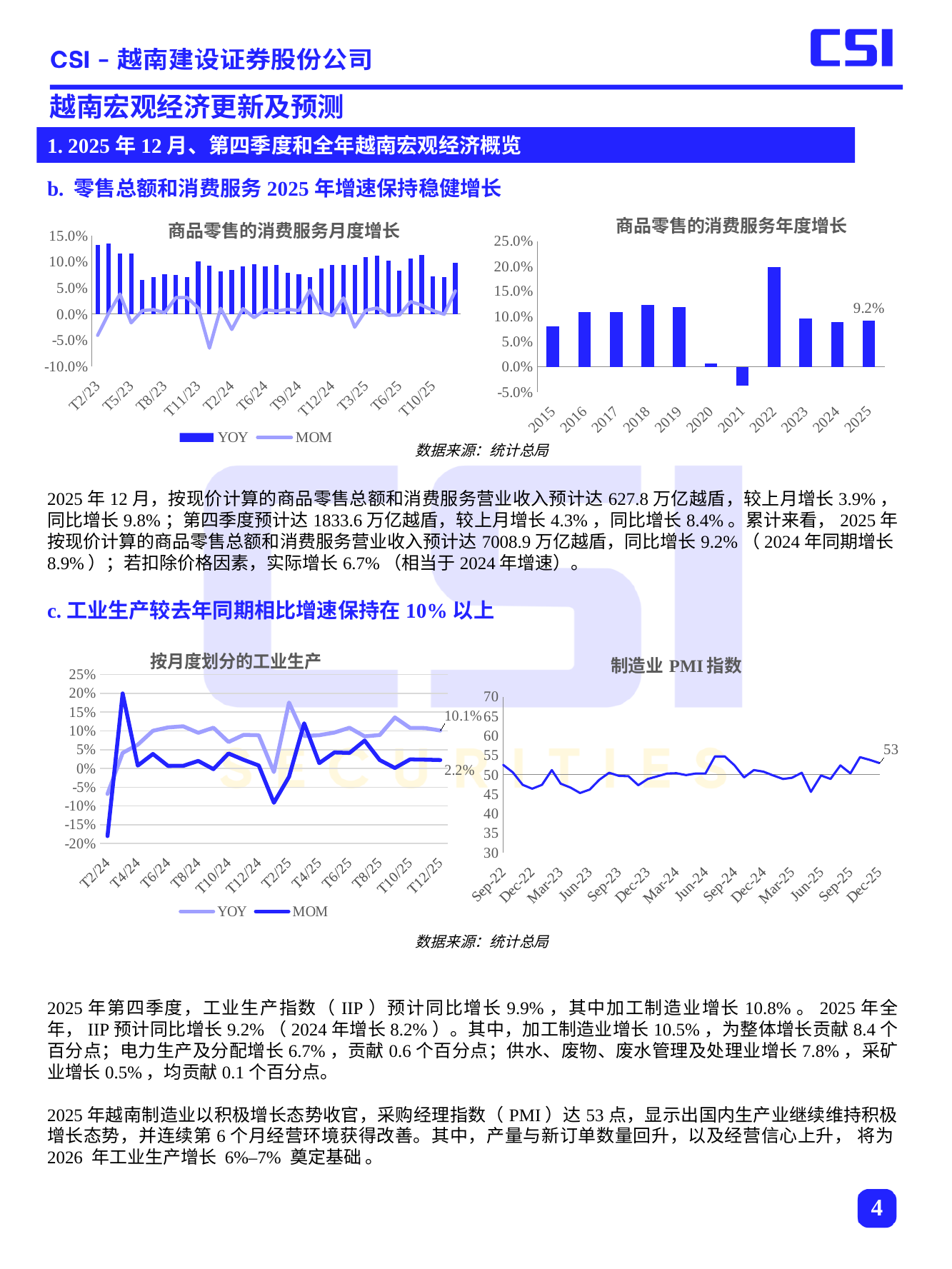
In the chart titled 制造业 PMI 指数, what is the value at Dec-25? 53 In the chart titled 按月度划分的工业生产, what is the YOY value at T12/25? 10.1% In the chart titled 商品零售的消费服务年度增长, which year has the lowest value? 2021 In the chart titled 商品零售的消费服务年度增长, how many years are shown on the x axis? 11 In the chart titled 商品零售的消费服务年度增长, what is the value for 2025? 9.2% In the chart titled 按月度划分的工业生产, how many series does the legend list? 2 In the chart titled 按月度划分的工业生产, what is the MOM value at T12/25? 2.2% What kind of chart is the one titled 制造业 PMI 指数? line chart What kind of chart is the one titled 商品零售的消费服务年度增长? bar chart In the chart titled 商品零售的消费服务年度增长, which year has the highest value? 2022 In the chart titled 商品零售的消费服务年度增长, is the value for 2022 greater or less than 15.0%? greater In the chart titled 商品零售的消费服务年度增长, is the value for 2021 greater or less than 0.0%? less